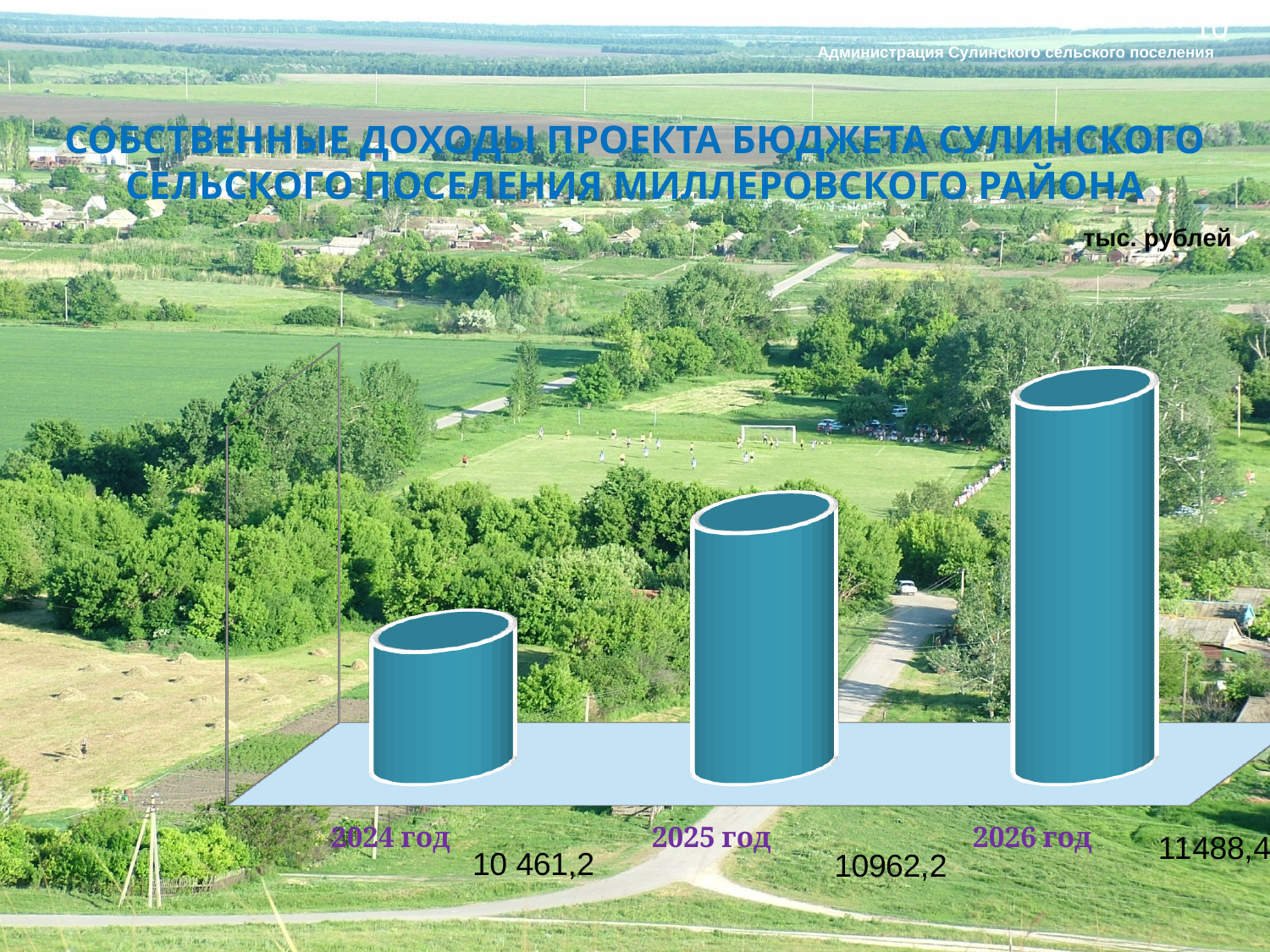
Do the values rise or fall from 2024 год to 2026 год? rise What kind of chart is shown on the slide? bar chart What unit of measurement is stated for the chart? тыс. рублей Which year has the lowest value? 2024 год What is the value for 2024 год? 10 461,2 What is the difference between the values for 2026 год and 2025 год? 526,2 Which year has the highest value? 2026 год What is the value for 2026 год? 11488,4 What is the difference between the values for 2025 год and 2024 год? 501 How many categories are shown in the chart? 3 Which is larger, the value for 2024 год or the value for 2026 год? 2026 год What is the value for 2025 год? 10962,2